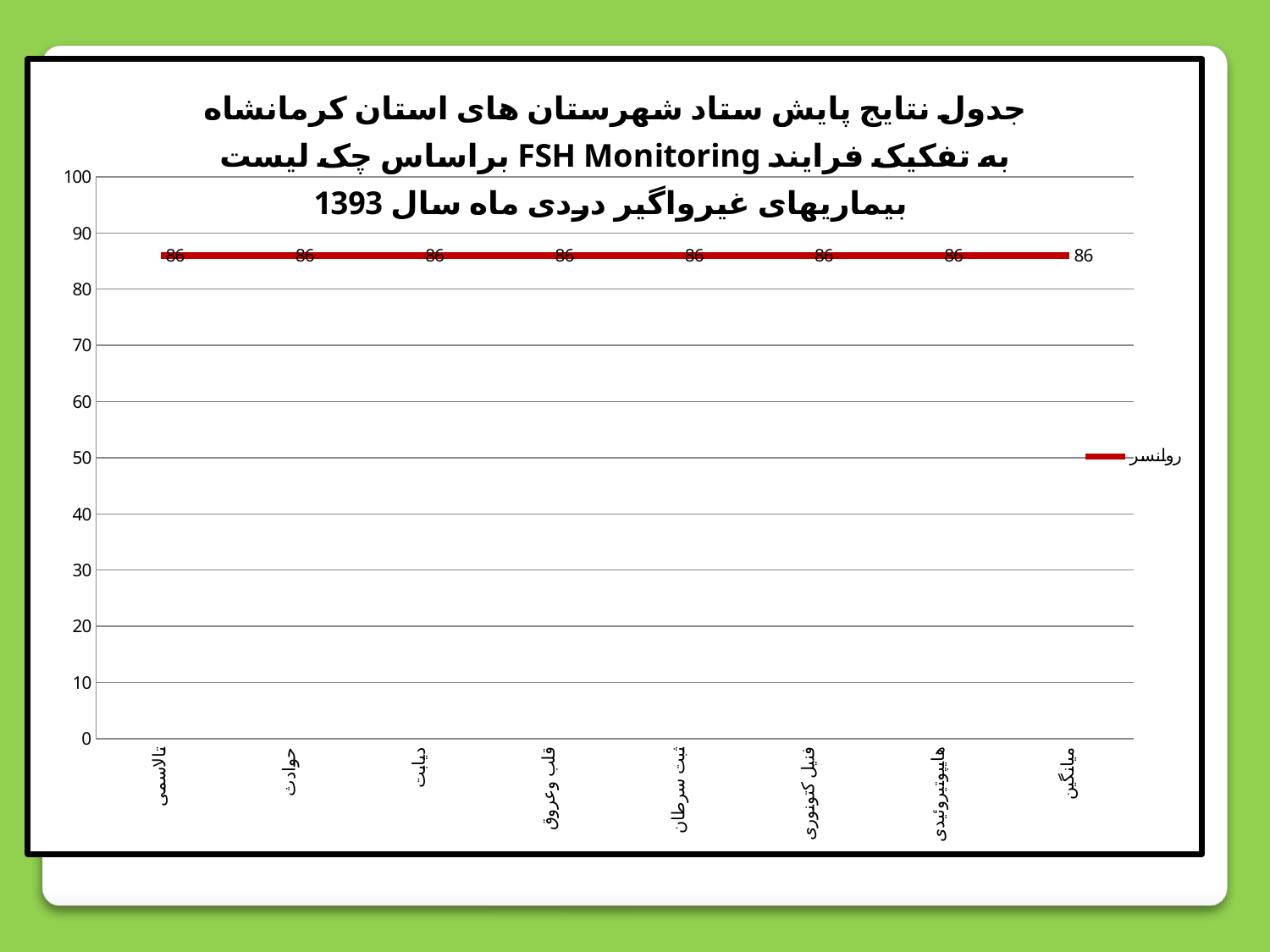
What is the value for تالاسمی? 86 How many categories are shown on the x axis? 8 What is the difference between the values for قلب وعروق and هایپوتیروئیدی? 0 Is the value for ثبت سرطان greater or less than 90? less What kind of chart is this? line chart Is the value for حوادث greater or less than 80? greater What is the value for فنیل کتونوری? 86 How many series does the legend list? 1 What is the name of the series shown in the legend? روانسر Do the values rise, fall, or stay flat across the categories? stay flat What is the value for دیابت? 86 What is the value for میانگین? 86